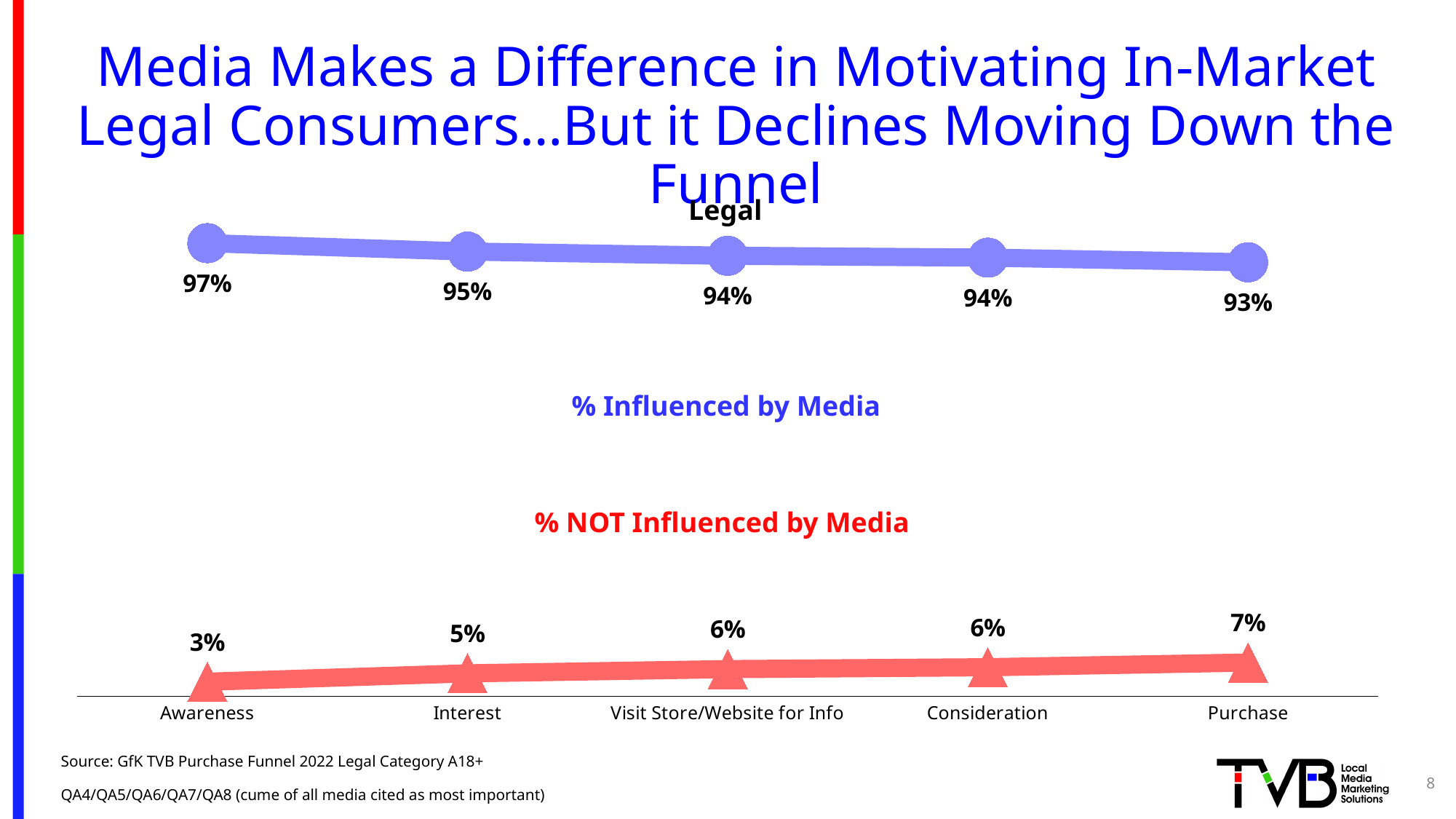
How many funnel stages are shown on the x axis? 5 At which stage is the % NOT Influenced by Media lowest? Awareness What is the % NOT Influenced by Media value at the Consideration stage? 6% How many data series are plotted on the chart? 2 What is the difference between the % Influenced by Media at Awareness and at Purchase? 4% Which is larger: the % NOT Influenced by Media at Interest or at Purchase? Purchase What kind of chart is shown on the slide? Line chart Does the % Influenced by Media rise or fall moving from Awareness to Purchase? Fall What is the % NOT Influenced by Media value at the Purchase stage? 7% At which stage is the % Influenced by Media highest? Awareness What is the % Influenced by Media value at the Interest stage? 95% What is the % Influenced by Media value at the Awareness stage? 97%